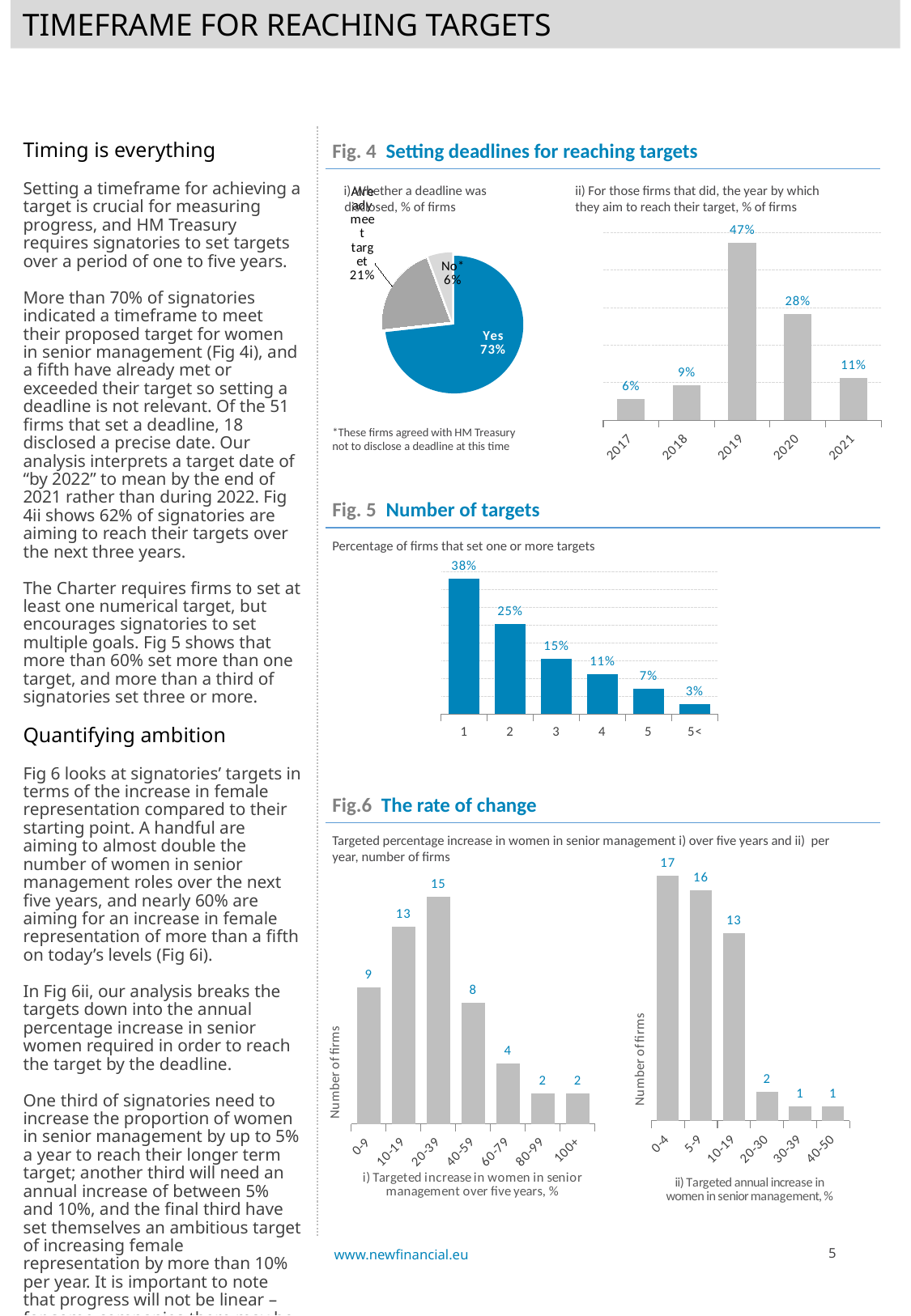
In the Fig. 6 chart of targeted annual increase in women in senior management, which is larger: the value for 0-4 or the value for 10-19? 0-4 In the Fig. 4 bar chart of the year by which firms aim to reach their target, what is the value for 2020? 28% In the Fig. 4 pie chart on whether a deadline was disclosed, what share of firms answered No? 6% What type of chart is Fig. 5 'Number of targets'? bar chart In the Fig. 5 'Number of targets' chart, which category has the lowest value? 5< In the Fig. 4 pie chart on whether a deadline was disclosed, what share of firms answered Yes? 73% In the Fig. 5 'Number of targets' chart, do the values rise or fall from left to right along the x axis? fall In the Fig. 5 'Number of targets' chart, what percentage of firms set 2 targets? 25% In the Fig. 6 chart of targeted increase in women in senior management over five years, how many firms are in the 20-39 category? 15 In the Fig. 4 bar chart of the year by which firms aim to reach their target, what is the difference between the values for 2019 and 2018? 38% In the Fig. 6 chart of targeted increase in women in senior management over five years, how many categories are shown on the x axis? 7 In the Fig. 4 bar chart of the year by which firms aim to reach their target, which year has the highest value? 2019